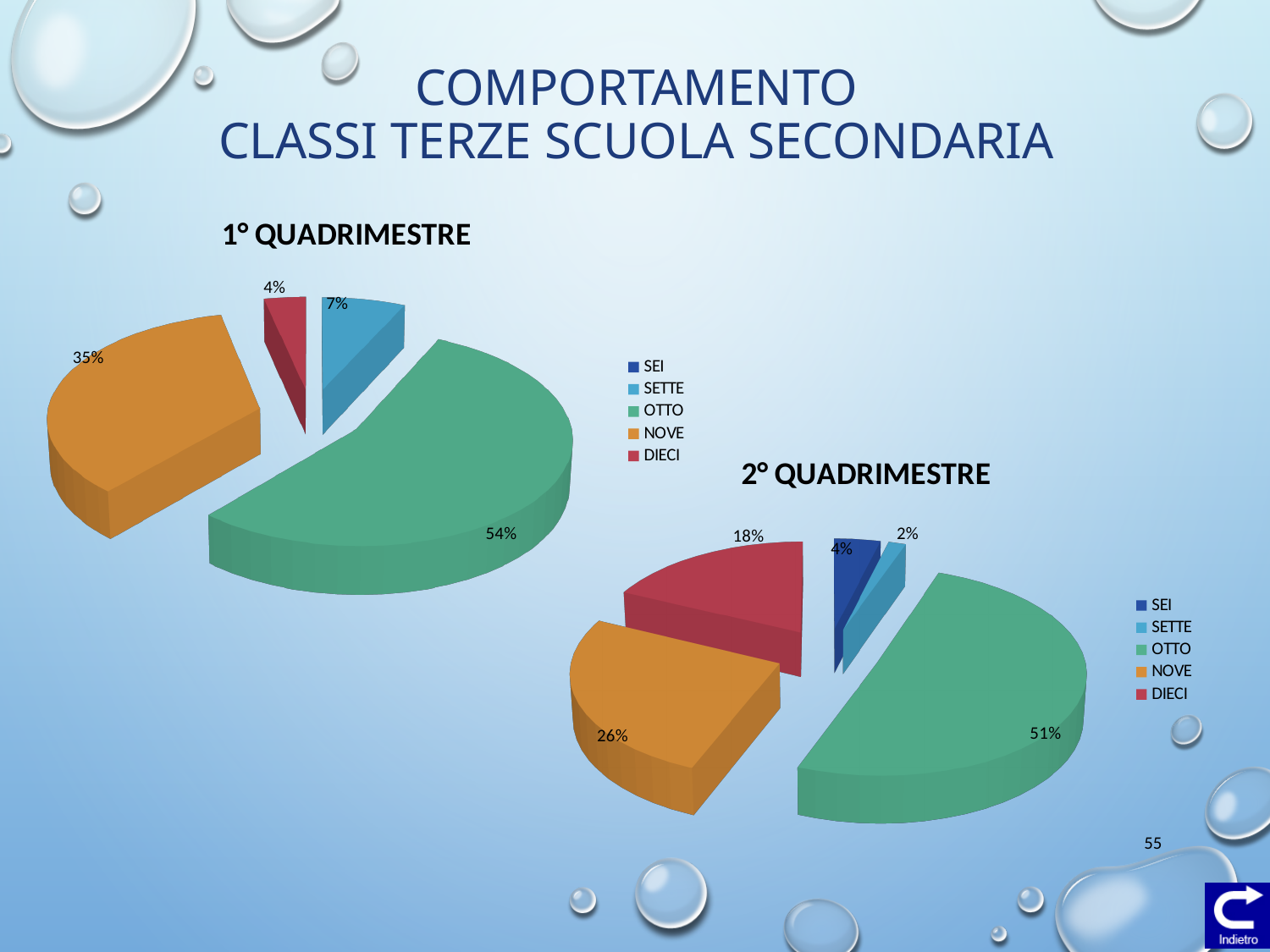
In the 2° QUADRIMESTRE chart, which category has the smallest share? SETTE In the 2° QUADRIMESTRE chart, what percentage is shown for SEI? 4% How many entries does the legend of the 2° QUADRIMESTRE chart list? 5 What is the title of the slide? COMPORTAMENTO CLASSI TERZE SCUOLA SECONDARIA What type of chart is the 1° QUADRIMESTRE chart? Pie chart In the 1° QUADRIMESTRE chart, what percentage is shown for OTTO? 54% In the 1° QUADRIMESTRE chart, what percentage is shown for SETTE? 7% In the 2° QUADRIMESTRE chart, which category has the largest share? OTTO In the 2° QUADRIMESTRE chart, what percentage is shown for DIECI? 18% In the 1° QUADRIMESTRE chart, what percentage is shown for NOVE? 35% In the 1° QUADRIMESTRE chart, what is the difference between the OTTO and NOVE percentages? 19% In the 2° QUADRIMESTRE chart, which is larger, NOVE or DIECI? NOVE